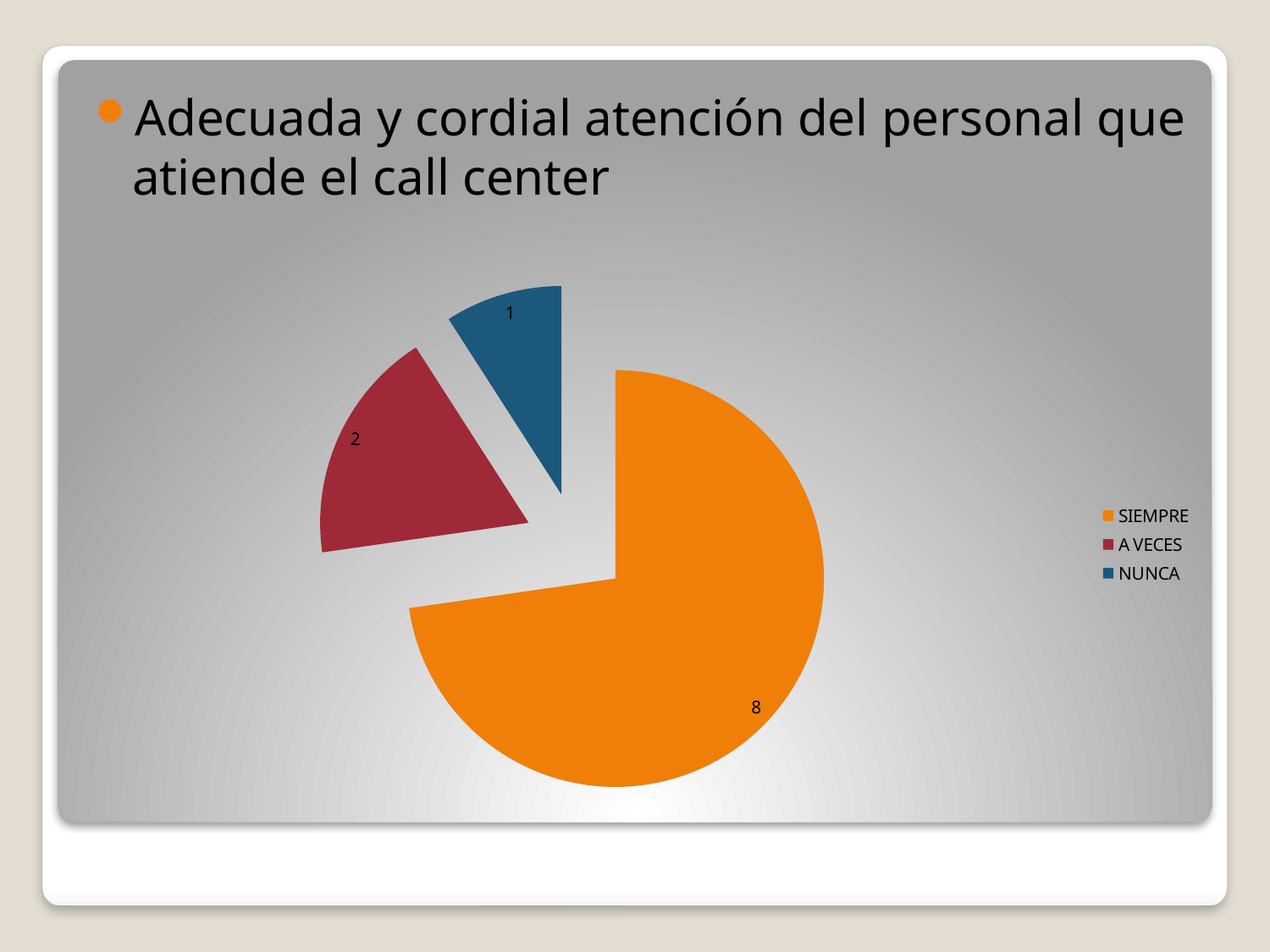
What kind of chart is shown on the slide? pie chart What is the difference between the values for SIEMPRE and A VECES? 6 What is the value for NUNCA? 1 Which category has the largest slice? SIEMPRE What is the value for A VECES? 2 What is the value for SIEMPRE? 8 Which category has the smallest slice? NUNCA What is the total of all the slice values? 11 Which is larger, the value for A VECES or the value for NUNCA? A VECES How many slices does the pie chart have? 3 What colour is the SIEMPRE slice? orange Which legend entry is shown in blue? NUNCA